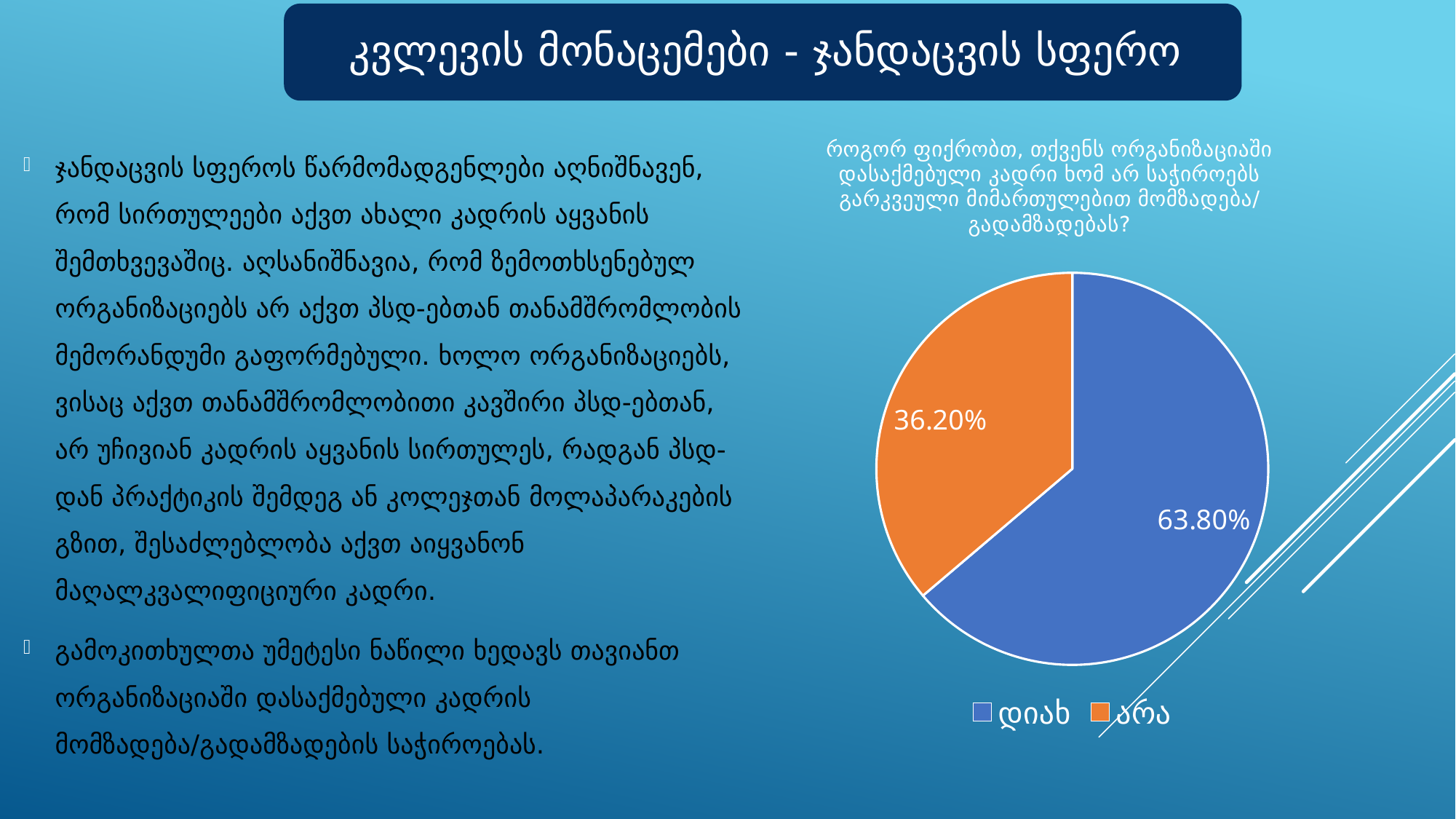
How many entries does the legend of the pie chart list? 2 What is the value for არა in the pie chart? 36.20% How many slices does the pie chart have? 2 Which category has the largest share of the pie chart? დიახ What is the value for დიახ in the pie chart? 63.80% What is the difference between the shares for დიახ and არა? 27.60% What colour is the slice for არა in the pie chart? orange What type of chart is shown on the slide? pie chart What share of the pie does the არა slice represent? 36.20% What colour is the slice for დიახ in the pie chart? blue Which category has the smallest share of the pie chart? არა Which is larger, the share for დიახ or the share for არა? დიახ